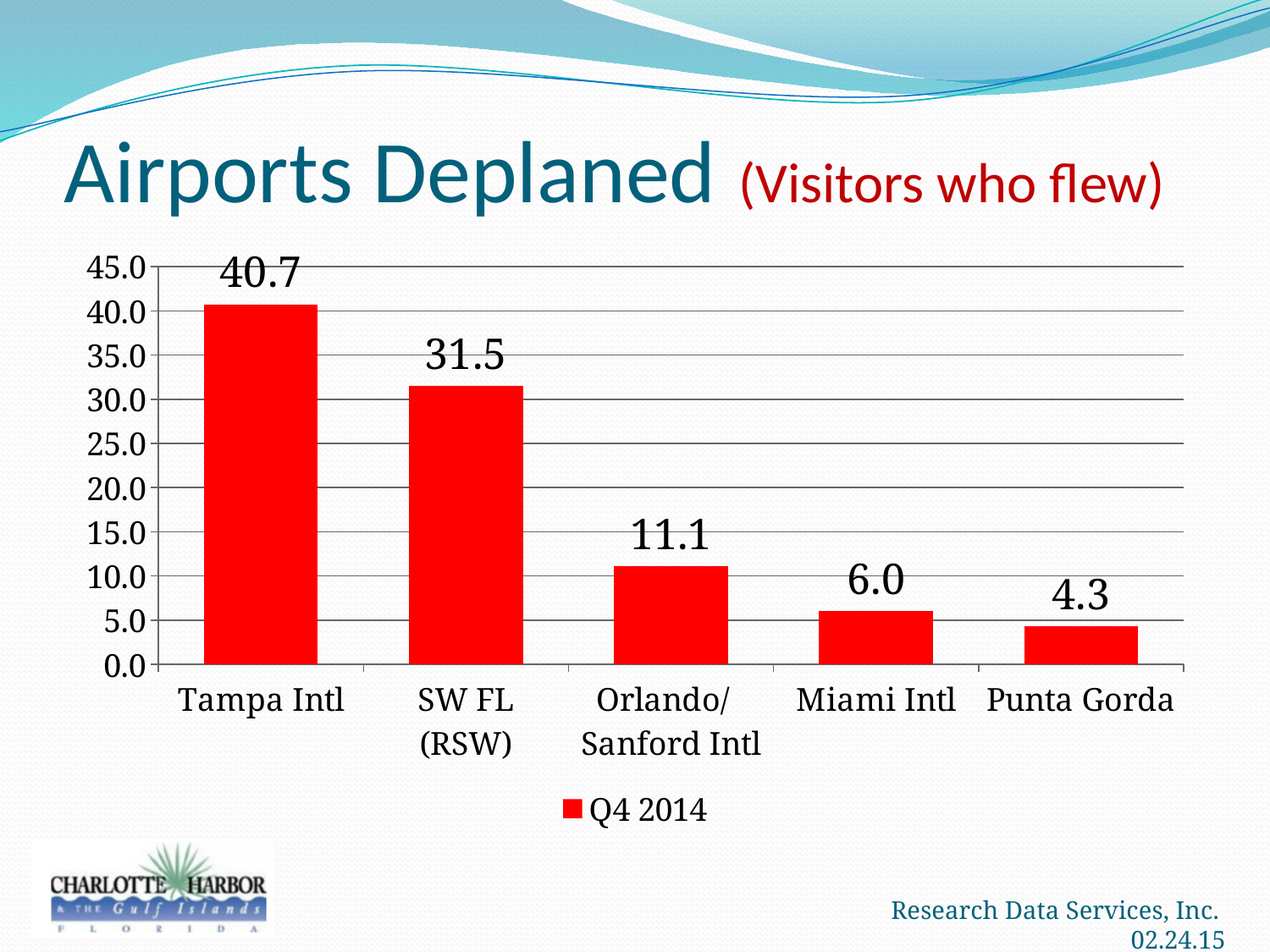
What kind of chart is shown on the slide? bar chart What is the value for Orlando/Sanford Intl? 11.1 Which airport has the highest value? Tampa Intl What is the difference between the values for Tampa Intl and SW FL (RSW)? 9.2 Which airport has the lowest value? Punta Gorda What is the value for Tampa Intl? 40.7 Which is larger, the value for Miami Intl or the value for Orlando/Sanford Intl? Orlando/Sanford Intl Is the value for Miami Intl greater or less than 10.0? less What is the value for Punta Gorda? 4.3 How many series does the legend list? 1 How many airports are shown on the chart? 5 What is the value for SW FL (RSW)? 31.5